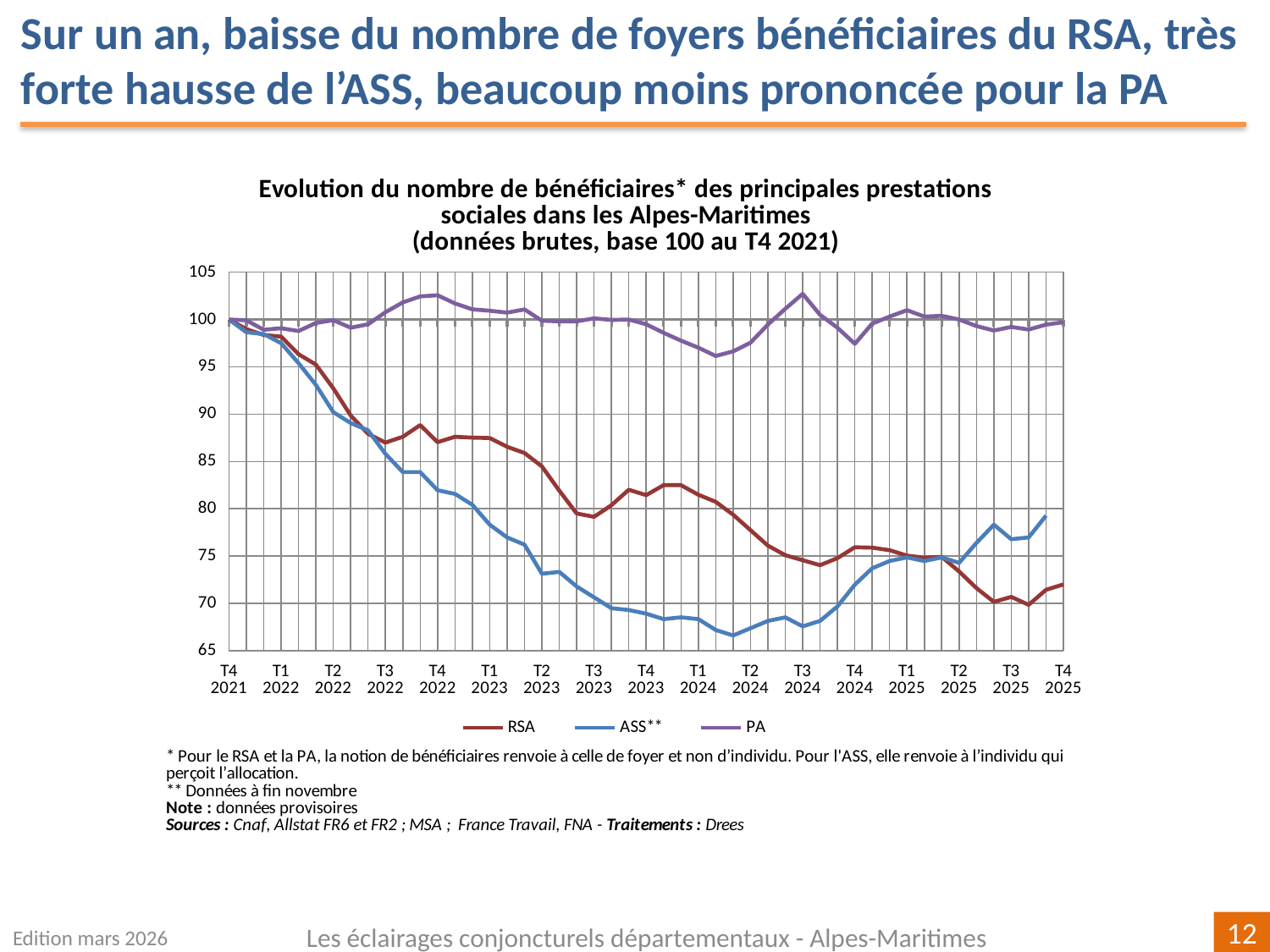
What is the value of all three series at T4 2021? 100 Which series has the lowest value at T4 2025? RSA Does the RSA series rise or fall overall from T4 2021 to T4 2025? fall Is the value for ASS** at T2 2024 greater or less than 70? less Is the value for PA at T3 2024 greater or less than 100? greater What kind of chart is shown on the slide? line chart Is the value for ASS** at T4 2025 greater or less than 75? greater How many quarter labels are shown on the x axis? 17 How many series does the legend list? 3 What are the three series listed in the legend? RSA, ASS**, PA At T4 2025, which series has the higher value, RSA or ASS**? ASS**